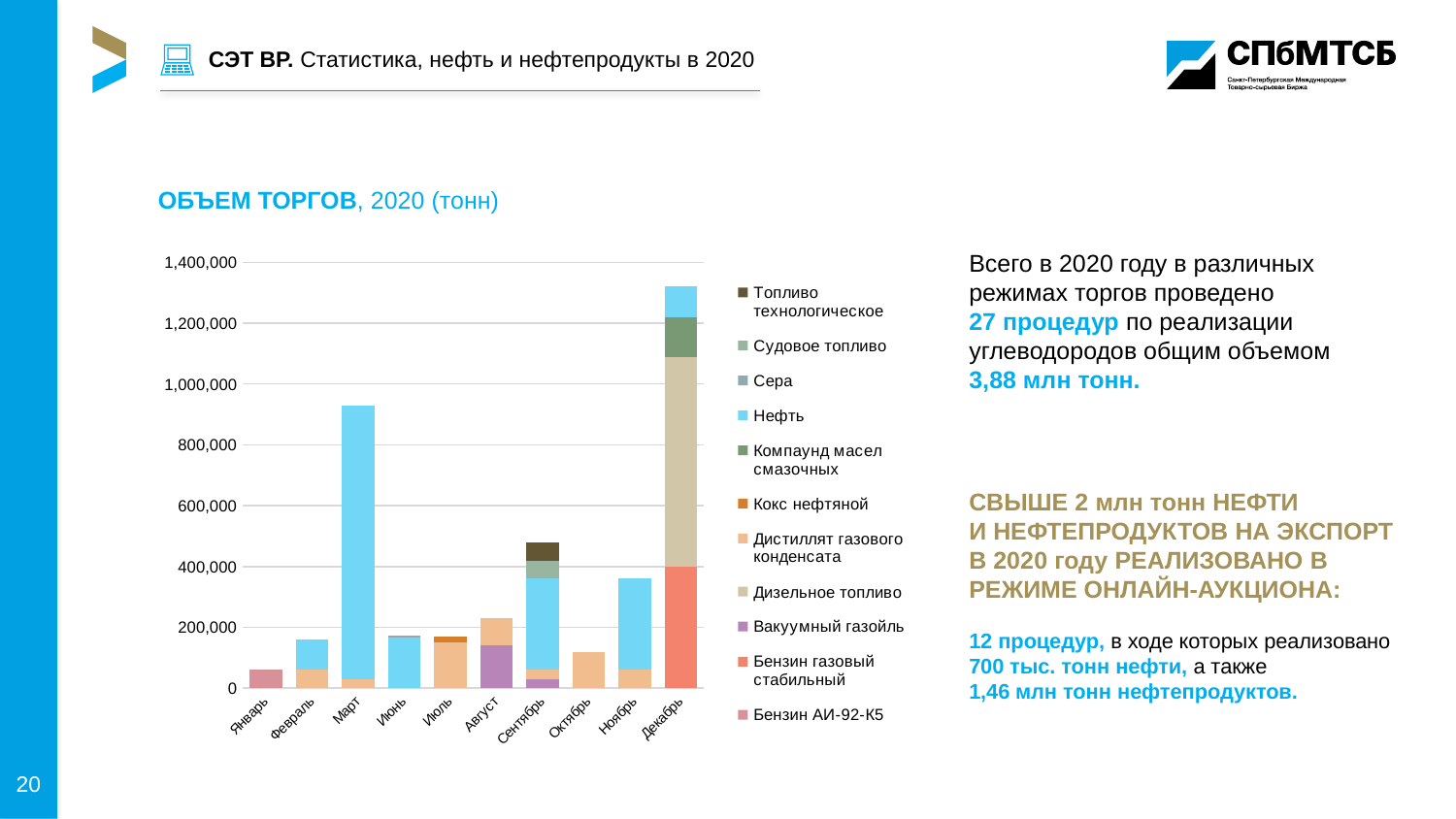
Which month has the highest total trading volume? Декабрь Which month has a larger total trading volume, Март or Ноябрь? Март Is the total value for Июнь greater or less than 200,000? less Is the total value for Декабрь greater or less than 1,200,000? greater How many months (categories) are shown on the x axis of the chart? 10 Is the total value for Март greater or less than 800,000? greater Which month has the lowest total trading volume? Январь What kind of chart is shown on the slide? Stacked bar chart What is the title of the chart? ОБЪЕМ ТОРГОВ, 2020 (тонн) How many series does the chart legend list? 11 Which series in the legend is shown in light blue? Нефть